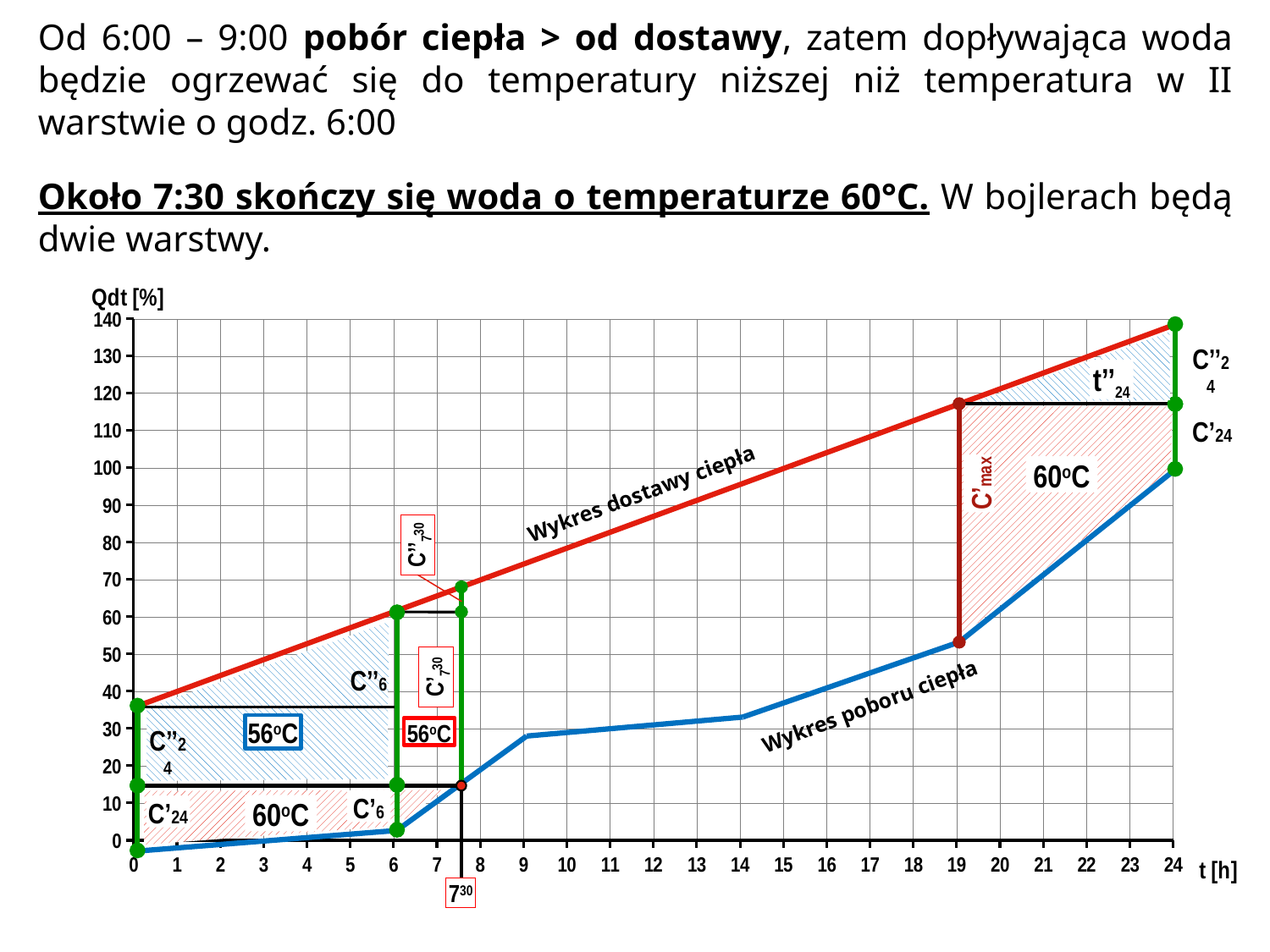
What is the label of the y axis of the chart? Qdt [%] What is the label of the x axis of the chart? t [h] What kind of chart is shown on the slide? line chart How many data series are plotted on the chart? 2 Which series reaches the highest value on the chart? Wykres dostawy ciepła Is the value of 'Wykres poboru ciepła' at t = 19 greater or less than 60? less Is the value of 'Wykres poboru ciepła' at t = 14 greater or less than 40? less Does 'Wykres dostawy ciepła' rise or fall as t increases from 0 to 24? rises Is the value of 'Wykres dostawy ciepła' at t = 24 greater or less than 130? greater At t = 19, which series has the higher value, 'Wykres dostawy ciepła' or 'Wykres poboru ciepła'? Wykres dostawy ciepła